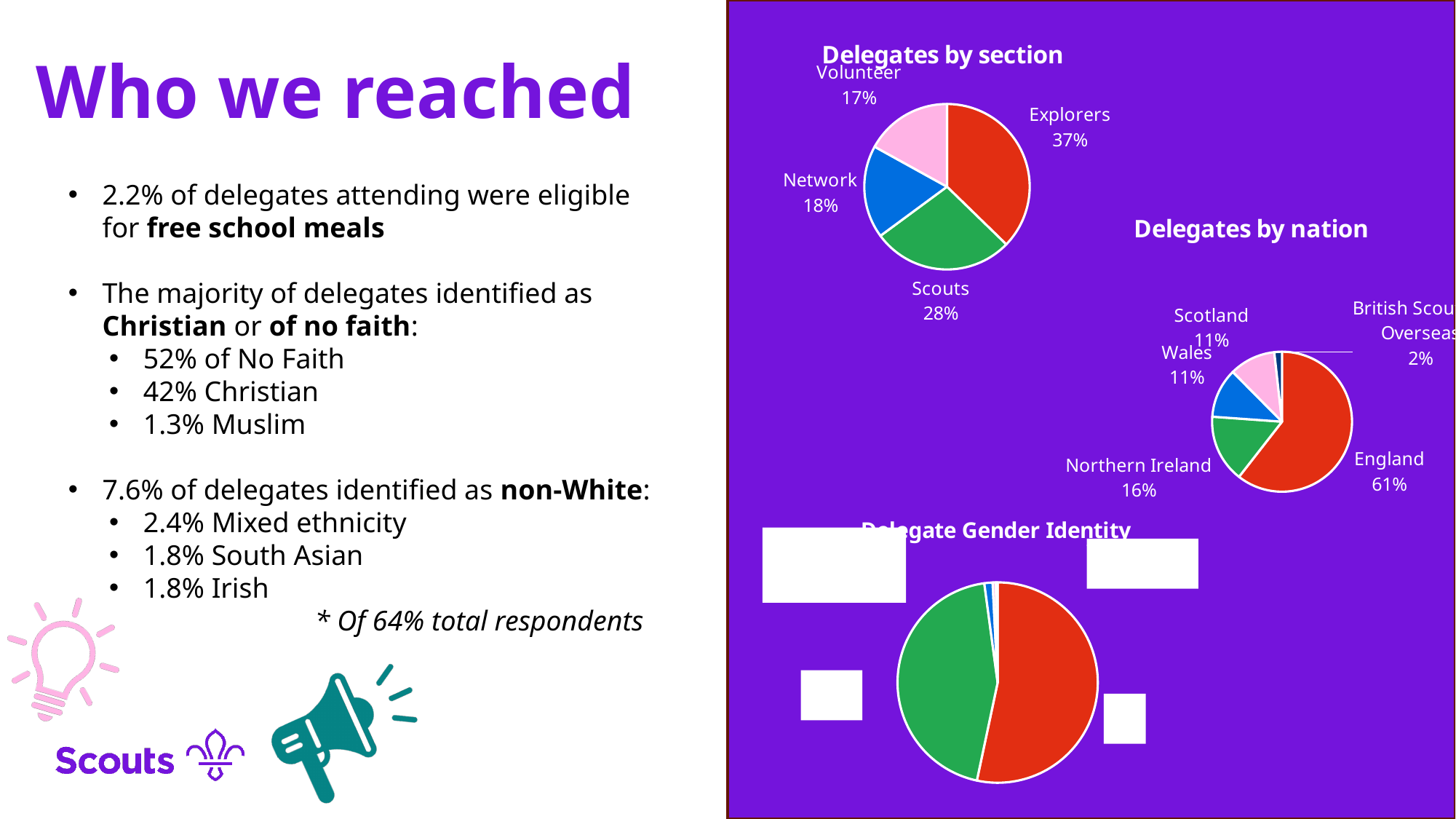
In the Delegates by nation chart, which is larger, the share for Northern Ireland or the share for Wales? Northern Ireland What is the title of the chart at the bottom of the purple panel? Delegate Gender Identity In the Delegates by section chart, what percentage is shown for Network? 18% How many sections are shown in the Delegates by section pie chart? 4 In the Delegates by nation chart, what percentage is shown for Northern Ireland? 16% What type of chart is used for Delegates by nation? Pie chart In the Delegates by section chart, which section has the smallest share? Volunteer In the Delegates by nation chart, what share of delegates came from England? 61% In the Delegates by nation chart, which nation has the largest share? England In the Delegates by section chart, which section has the largest share? Explorers In the Delegates by section chart, how many percentage points larger is the Explorers share than the Scouts share? 9 In the Delegates by section chart, what share of delegates were Explorers? 37%